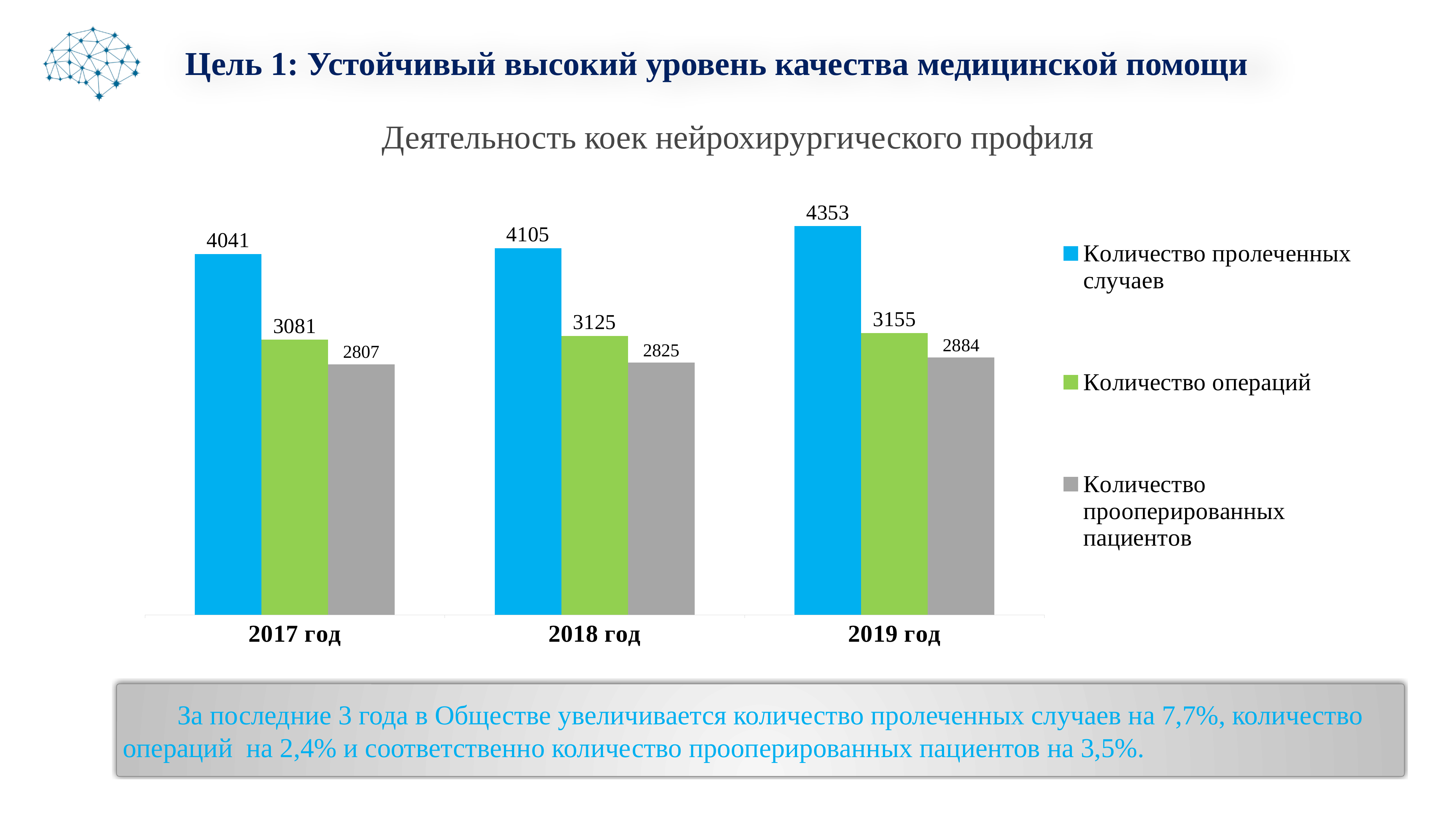
In which year is the number of treated cases (Количество пролеченных случаев) highest? 2019 год What kind of chart is shown on the slide? Bar chart How many years are shown on the x axis of the chart? 3 What is the number of treated cases (Количество пролеченных случаев) in 2019 год? 4353 Does the number of treated cases (Количество пролеченных случаев) rise or fall from 2017 год to 2019 год? Rise In which year is the number of operated patients (Количество прооперированных пациентов) lowest? 2017 год What is the number of operations (Количество операций) in 2017 год? 3081 What is the number of operated patients (Количество прооперированных пациентов) in 2018 год? 2825 What is the difference between the number of treated cases in 2019 год and in 2017 год? 312 How many series does the legend list? 3 Which is larger in 2018 год: the number of operations or the number of operated patients? Количество операций What is the difference between the number of operations and the number of operated patients in 2019 год? 271